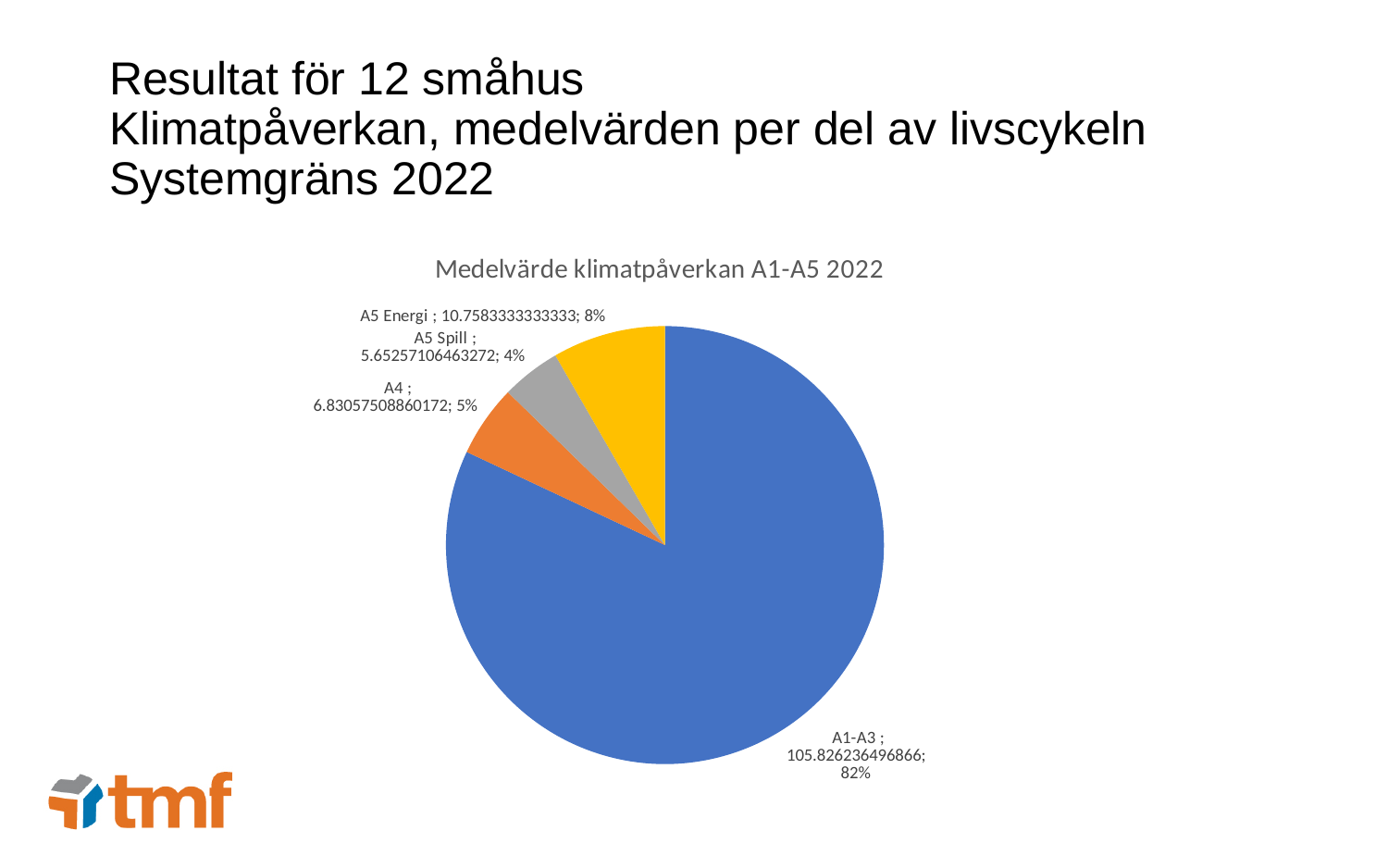
What share of the pie does A5 Spill represent? 4% What share of the pie does A4 represent? 5% Which is larger, the slice for A5 Energi or the slice for A4? A5 Energi What kind of chart is shown on the slide? Pie chart How many slices does the pie chart have? 4 Which category has the largest slice of the pie? A1-A3 What share of the pie does A1-A3 represent? 82% What is the value shown for A5 Energi? 10.7583333333333 Which category has the smallest slice of the pie? A5 Spill What is the title of the chart? Medelvärde klimatpåverkan A1-A5 2022 What is the value shown for A1-A3? 105.826236496866